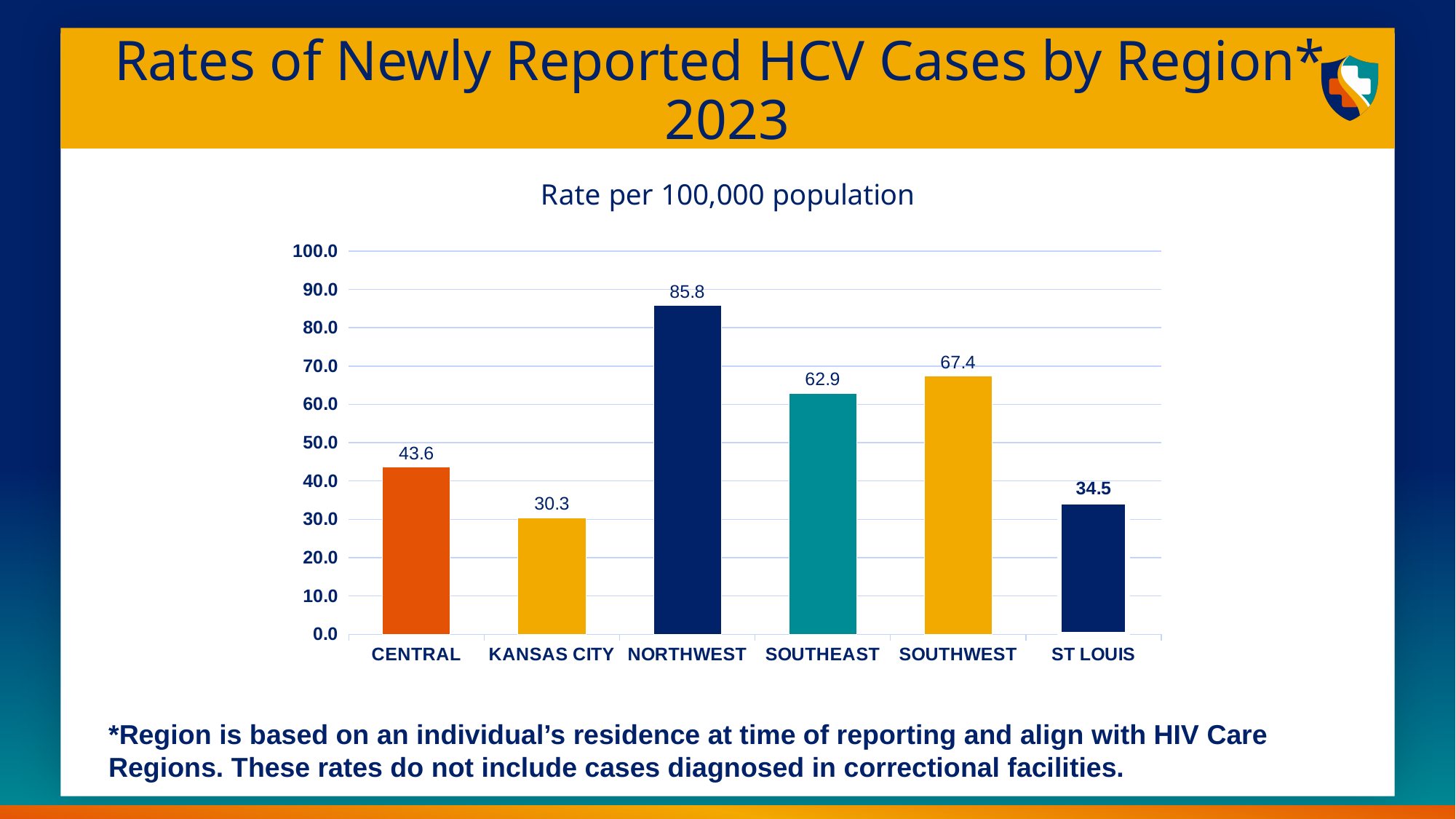
What is the difference between the Southwest and Southeast rates? 4.5 What is the rate per 100,000 population for St Louis? 34.5 Which region has the lowest rate of newly reported HCV cases? Kansas City Which region has a higher rate, Central or St Louis? Central Which region has the highest rate of newly reported HCV cases? Northwest What is the chart's subtitle describing the unit of measurement? Rate per 100,000 population What is the difference between the Northwest and Central rates? 42.2 What is the rate per 100,000 population for the Northwest region? 85.8 What is the rate per 100,000 population for Kansas City? 30.3 Is the value for Southeast greater or less than 60.0? greater What kind of chart is shown on the slide? Bar chart How many regions are shown on the chart? 6